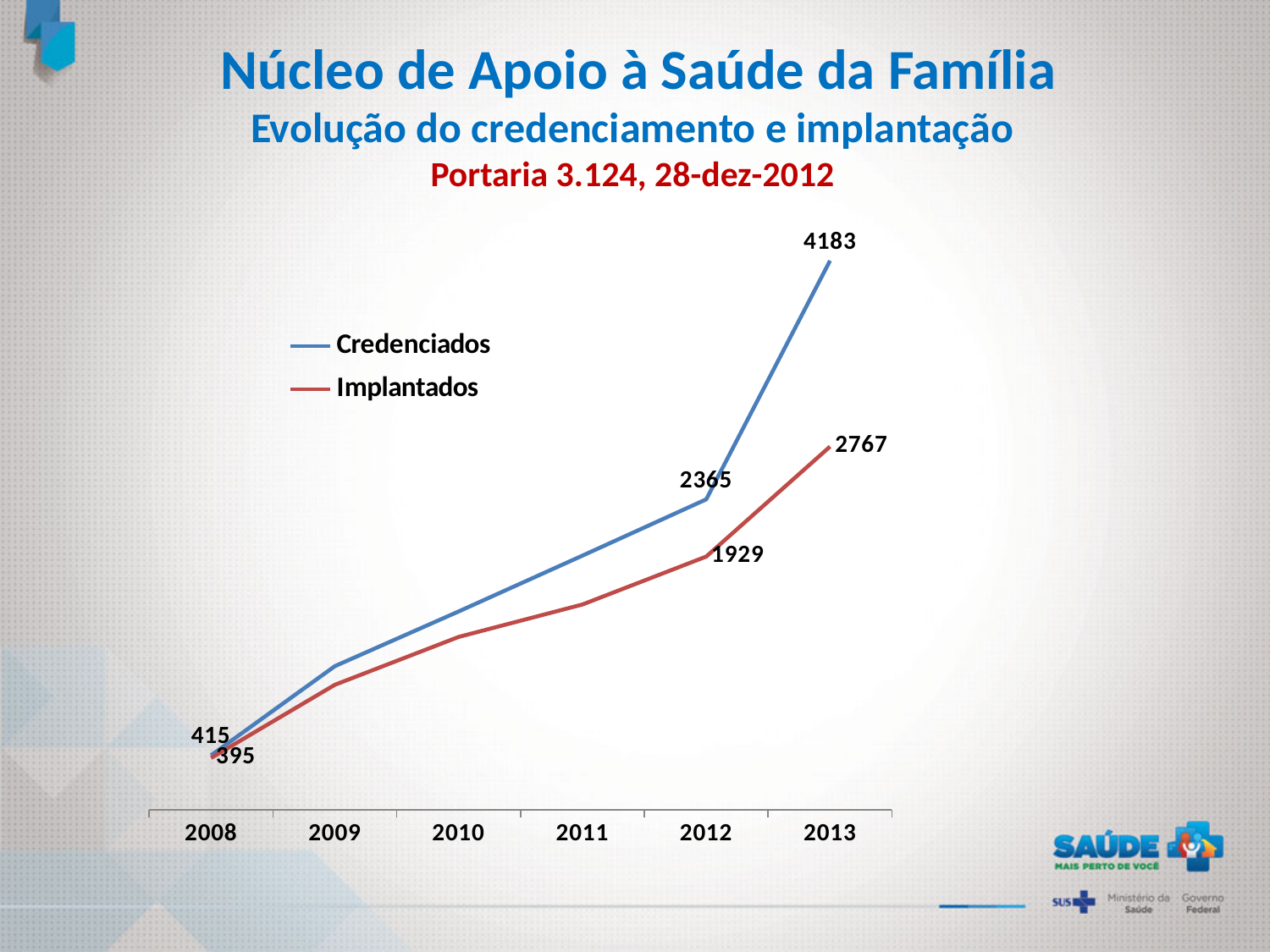
How many years are shown on the x axis? 6 What is the value for Credenciados in 2012? 2365 What is the difference between Credenciados in 2012 and Implantados in 2012? 436 What is the value for Implantados in 2008? 395 How many series does the legend list? 2 Which colour is used for the Implantados line? Red What is the value for Credenciados in 2013? 4183 What is the difference between Credenciados and Implantados in 2013? 1416 What type of chart is shown on the slide? Line chart Do the Credenciados values rise or fall from 2008 to 2013? Rise Which series has the higher value in 2013, Credenciados or Implantados? Credenciados What is the value for Implantados in 2013? 2767